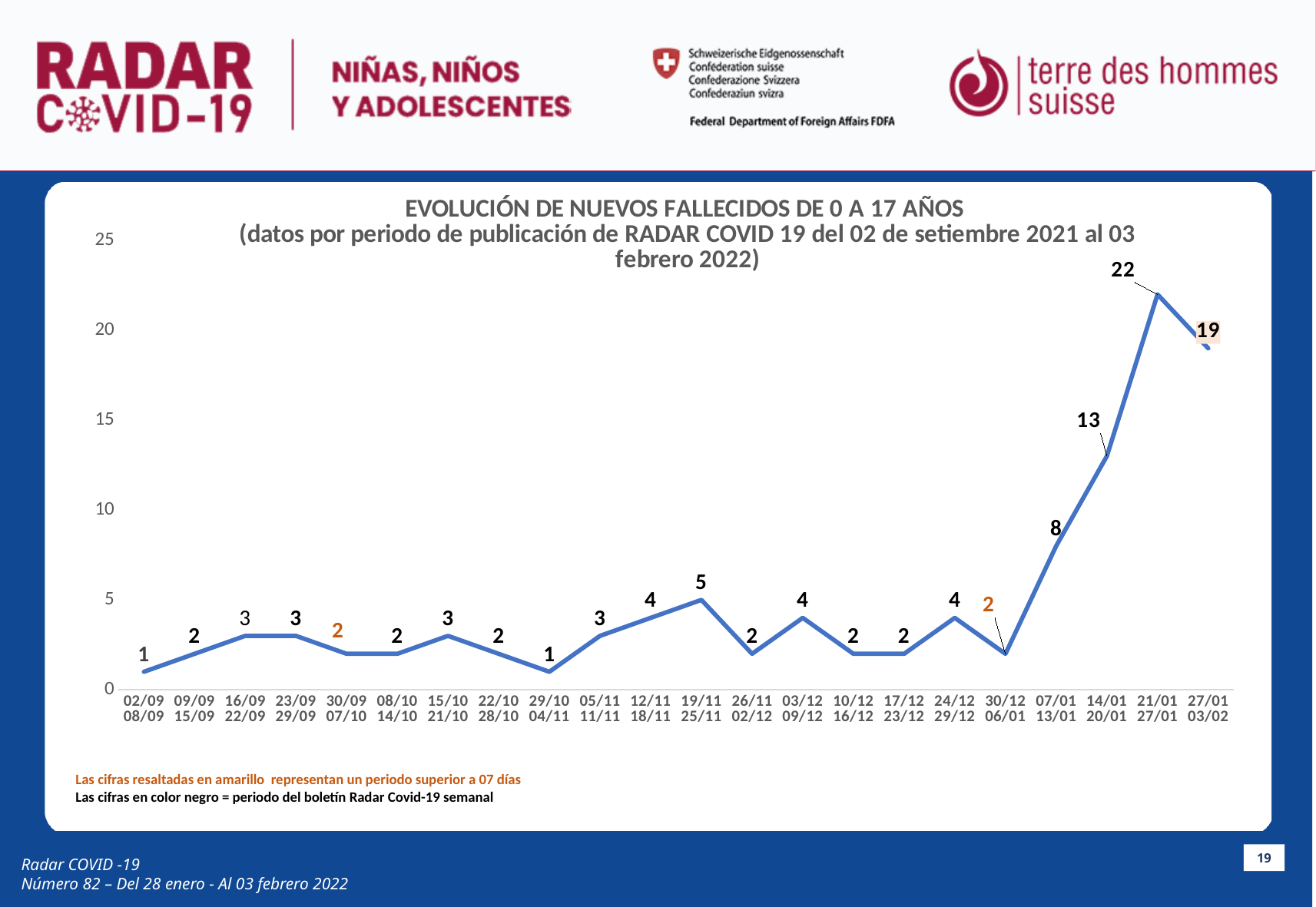
What is the difference between the values for 21/01–27/01 and 27/01–03/02? 3 Which period has the highest value? 21/01–27/01 What is the lowest value plotted on the chart? 1 What is the value for the period 19/11–25/11? 5 What is the value for the period 21/01–27/01? 22 What type of chart is shown on the slide? line chart How many periods (data points) are plotted on the chart? 22 What is the difference between the values for 14/01–20/01 and 07/01–13/01? 5 Which is larger, the value for 03/12–09/12 or the value for 10/12–16/12? 03/12–09/12 What is the value for the period 14/01–20/01? 13 What is the value for the period 27/01–03/02? 19 According to the note below the chart, what do the orange-highlighted figures represent? un periodo superior a 07 días